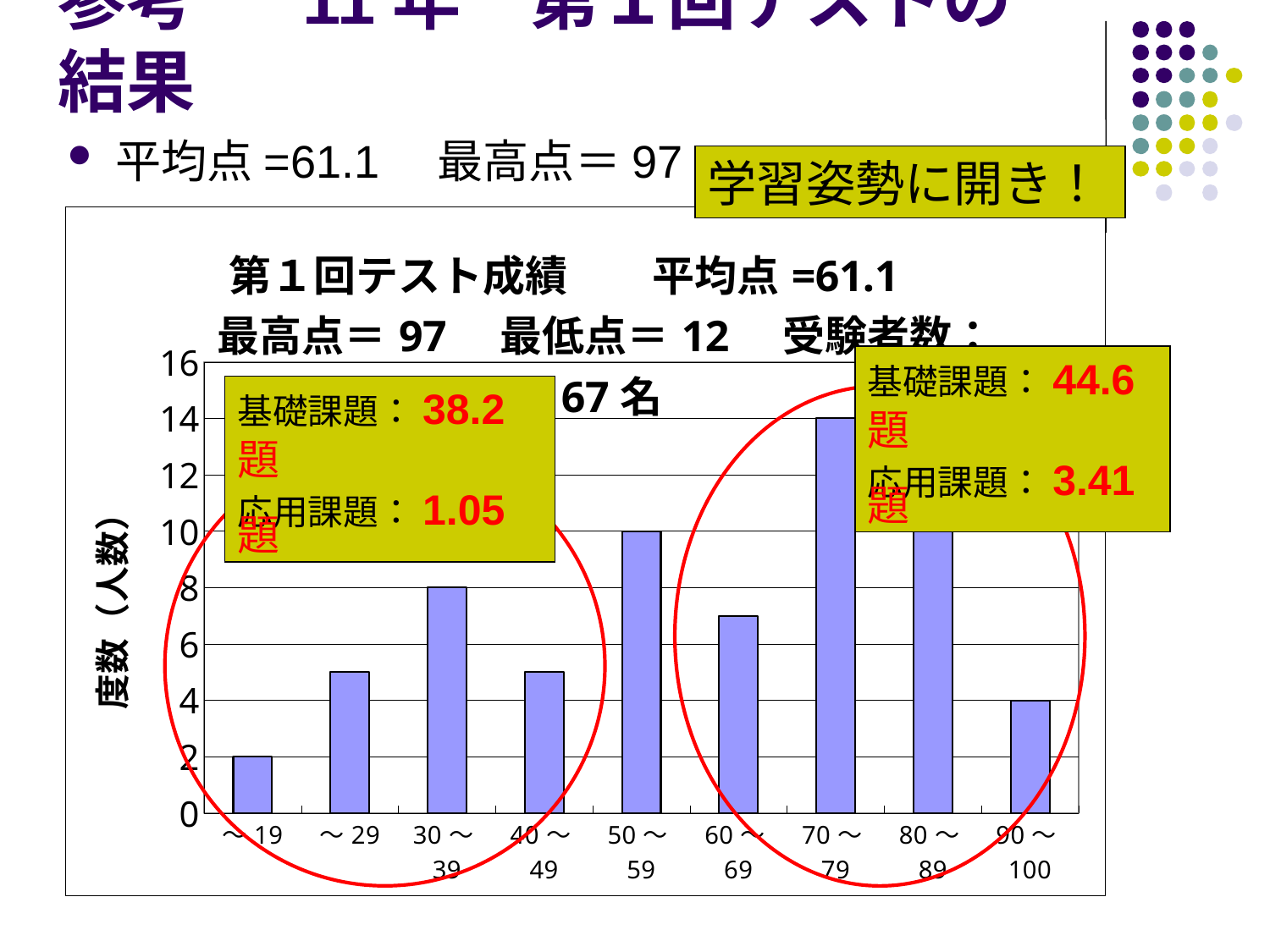
Which score range has a larger frequency, 50～59 or 90～100? 50～59 Which score range has the lowest frequency (度数) in the chart? ～19 What is the frequency (人数) for the 70～79 score range? 14 What is the frequency (人数) for the 30～39 score range? 8 What is the difference in frequency between the 70～79 and 30～39 score ranges? 6 What is the frequency (人数) for the ～19 score range? 2 Is the frequency for the 40～49 score range greater or less than 6? less What kind of chart is shown on the slide? bar chart How many score ranges (categories) are shown on the x axis of the chart? 9 What is the frequency (人数) for the 90～100 score range? 4 Is the frequency for the 60～69 score range greater or less than 6? greater Which score range has the highest frequency (度数) in the chart? 70～79